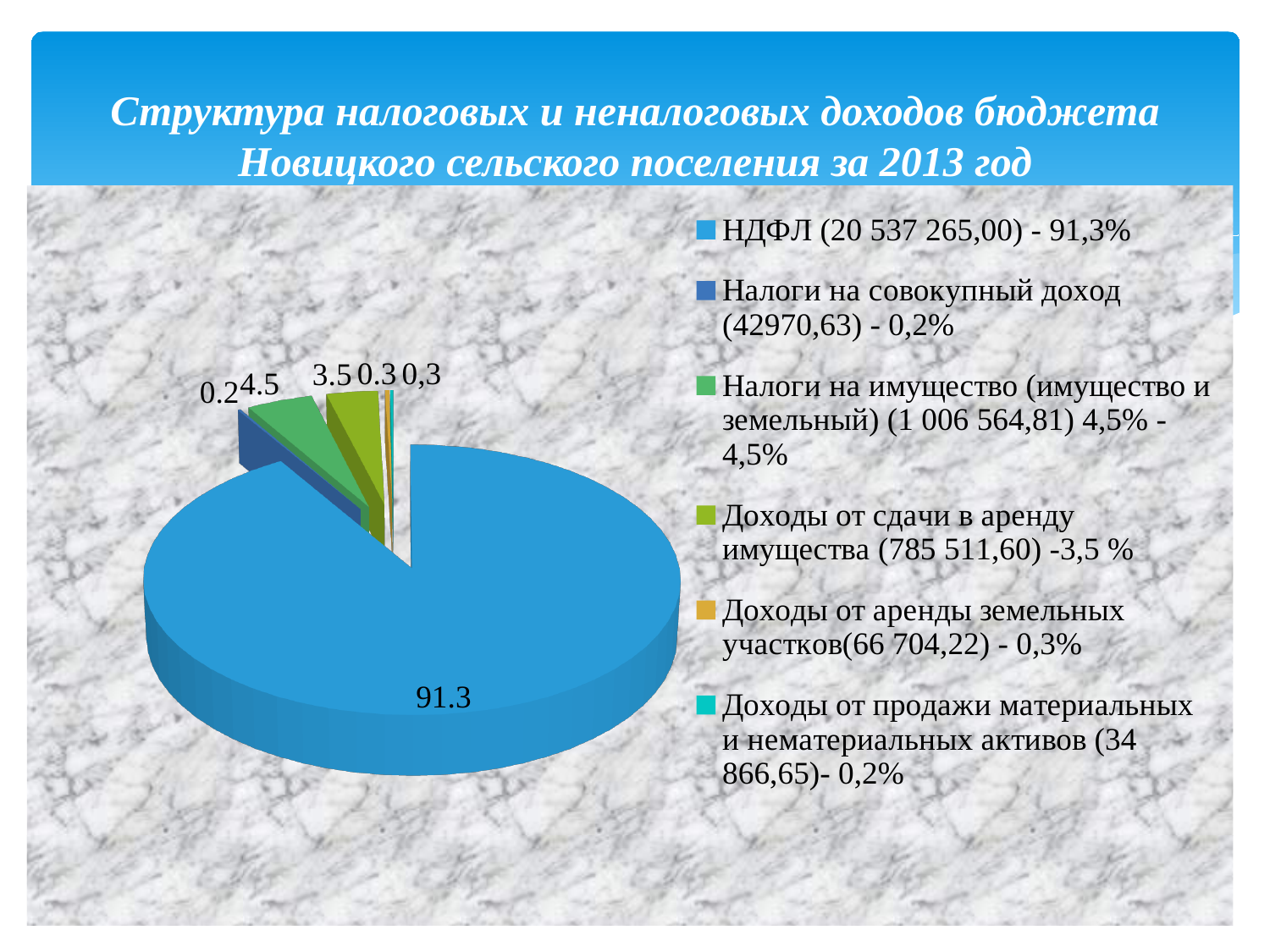
What value is labelled on the slice for Доходы от сдачи в аренду имущества? 3.5 What value is labelled on the НДФЛ slice? 91.3 What value is labelled on the slice for Налоги на совокупный доход? 0.2 Which category has the largest slice of the pie? НДФЛ What is the difference between the labelled values for Налоги на имущество (4.5) and Доходы от сдачи в аренду имущества (3.5)? 1 How many slices does the pie chart have? 6 What kind of chart is shown on the slide? pie chart Which is larger: the slice for Налоги на имущество or the slice for Доходы от сдачи в аренду имущества? Налоги на имущество What value is labelled on the slice for Налоги на имущество (имущество и земельный)? 4.5 How many entries does the legend list? 6 What is the difference between the labelled values for НДФЛ (91.3) and Налоги на имущество (4.5)? 86.8 What colour is the НДФЛ slice in the pie chart? blue